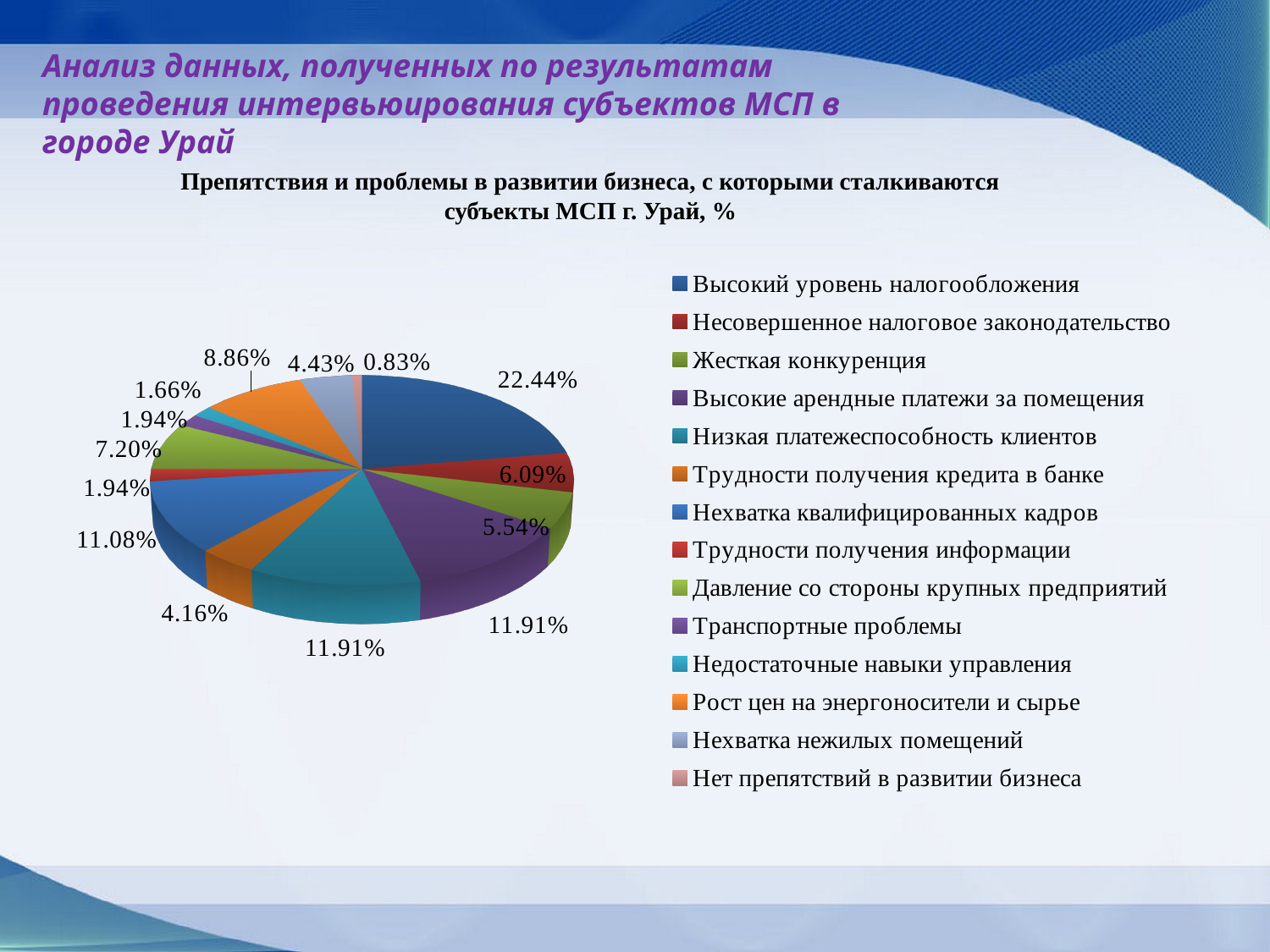
Which category has the largest share of the pie? Высокий уровень налогообложения What is the value for Нет препятствий в развитии бизнеса? 0.83% Which is larger: Давление со стороны крупных предприятий or Несовершенное налоговое законодательство? Давление со стороны крупных предприятий What is the title of the chart? Препятствия и проблемы в развитии бизнеса, с которыми сталкиваются субъекты МСП г. Урай, % What is the value for Трудности получения кредита в банке? 4.16% How many categories does the legend list? 14 What kind of chart is shown on the slide? pie chart What is the value for Высокий уровень налогообложения? 22.44% What is the difference between the values for Высокий уровень налогообложения and Нехватка квалифицированных кадров? 11.36% Which category has the smallest share of the pie? Нет препятствий в развитии бизнеса What is the value for Рост цен на энергоносители и сырье? 8.86% What is the value for Нехватка квалифицированных кадров? 11.08%